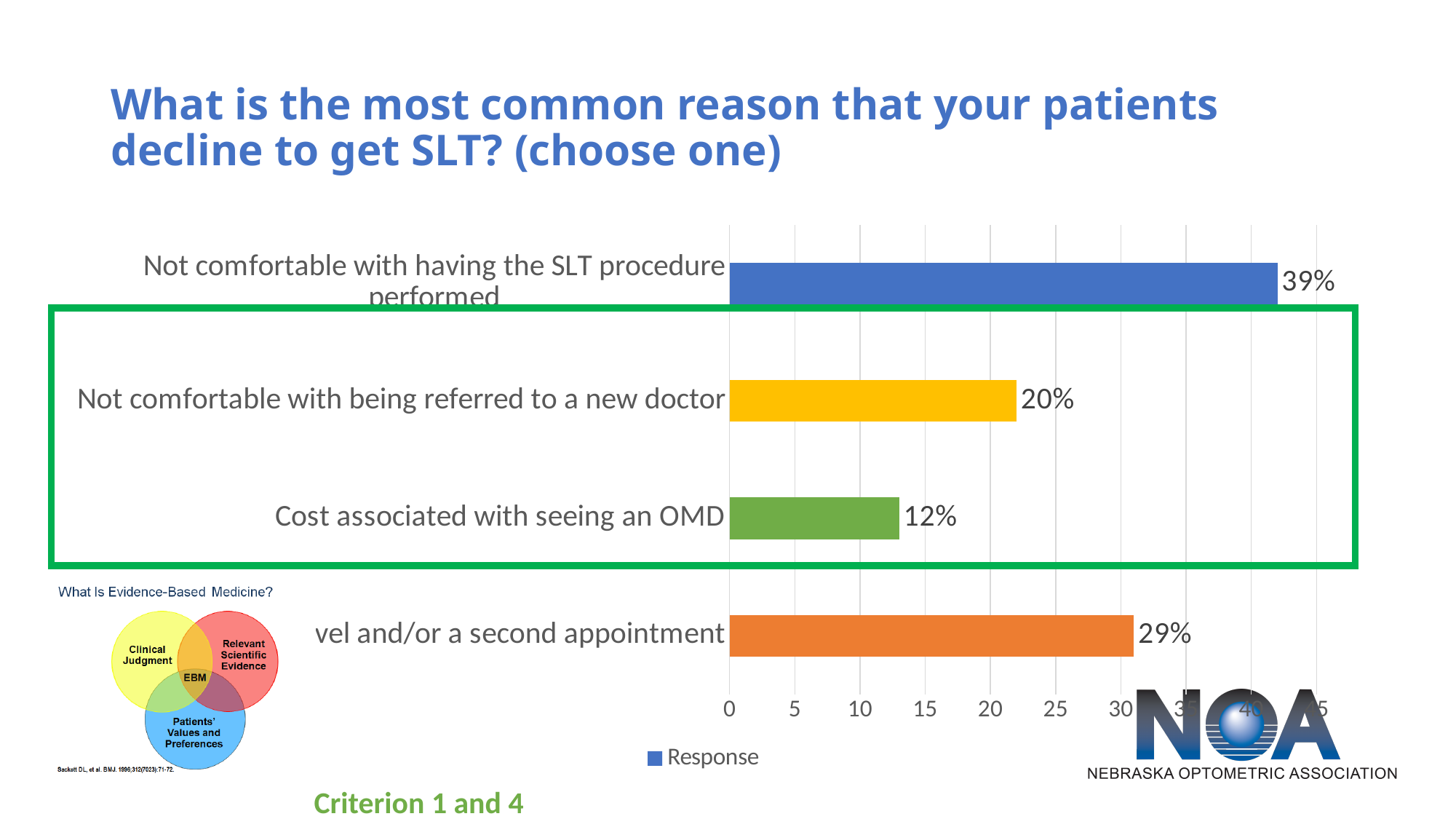
On the horizontal axis, does the bar for "Cost associated with seeing an OMD" extend to greater or less than 15? less What is the difference between the values for "Not comfortable with having the SLT procedure performed" and "Not comfortable with being referred to a new doctor"? 19 percentage points What is the value shown on the bottom (orange) bar of the chart? 29% What is the value shown for "Not comfortable with having the SLT procedure performed"? 39% How many series does the chart legend list? 1 What is the value shown for "Not comfortable with being referred to a new doctor"? 20% Which category has the highest value in the chart? Not comfortable with having the SLT procedure performed Which is larger: the value for "Not comfortable with being referred to a new doctor" or the value for "Cost associated with seeing an OMD"? Not comfortable with being referred to a new doctor Which category has the lowest value in the chart? Cost associated with seeing an OMD What type of chart is shown on the slide? bar chart How many categories (bars) are shown in the chart? 4 What is the value shown for "Cost associated with seeing an OMD"? 12%